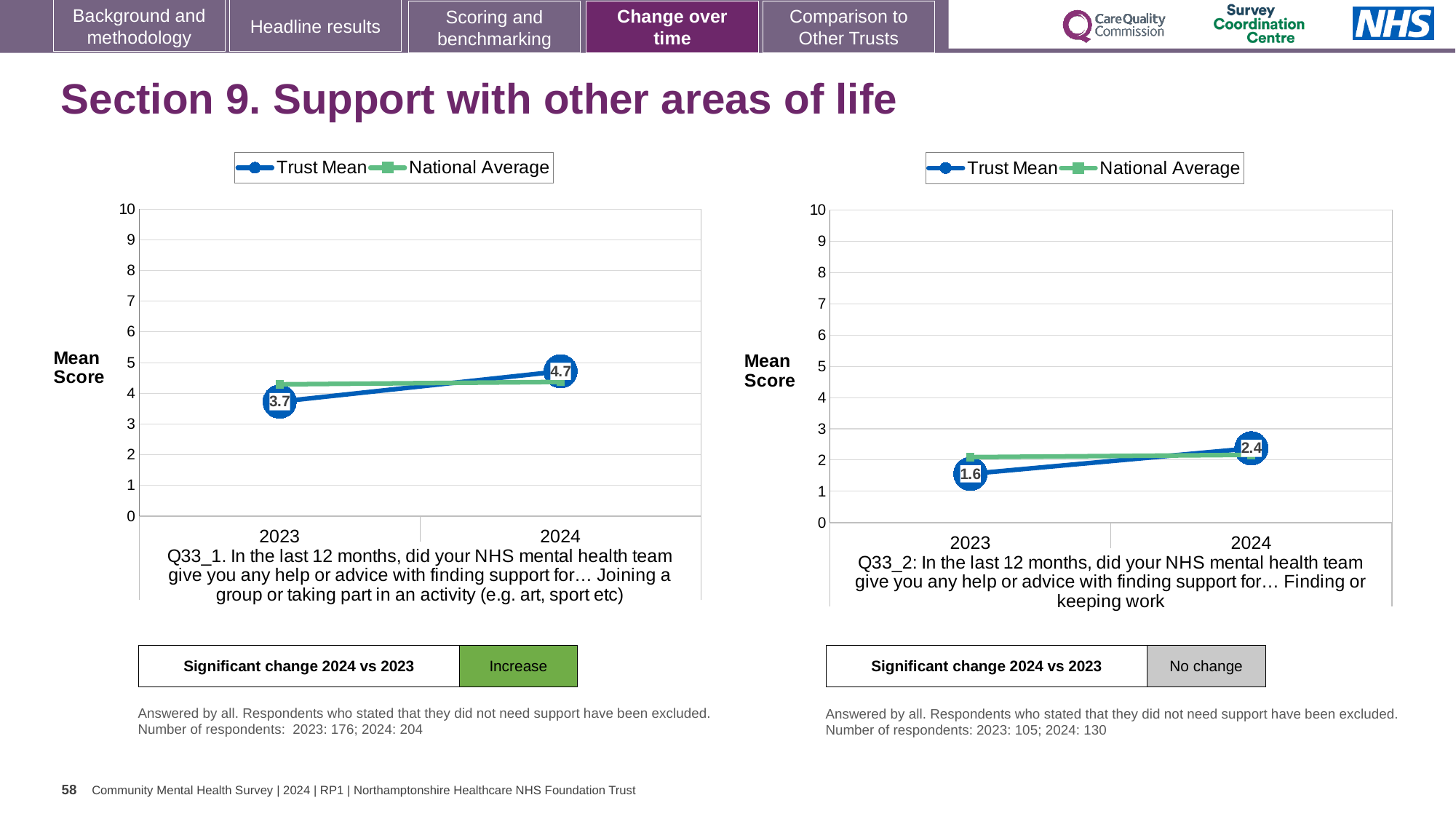
How many years are plotted on the x axis of the right chart (Q33_2)? 2 In the left chart (Q33_1), which is larger in 2023, the Trust Mean or the National Average? National Average How many series does the legend of the left chart (Q33_1) list? 2 What kind of chart is the right chart (Q33_2)? line chart In the right chart (Q33_2), by how much did the Trust Mean change from 2023 to 2024? 0.8 In the left chart (Q33_1), does the Trust Mean rise or fall from 2023 to 2024? rise In the right chart (Q33_2), what is the Trust Mean for 2023? 1.6 In the left chart (Q33_1), what is the Trust Mean for 2024? 4.7 In the left chart (Q33_1), what is the Trust Mean for 2023? 3.7 In the left chart (Q33_1), by how much did the Trust Mean change from 2023 to 2024? 1.0 In the right chart (Q33_2), what is the Trust Mean for 2024? 2.4